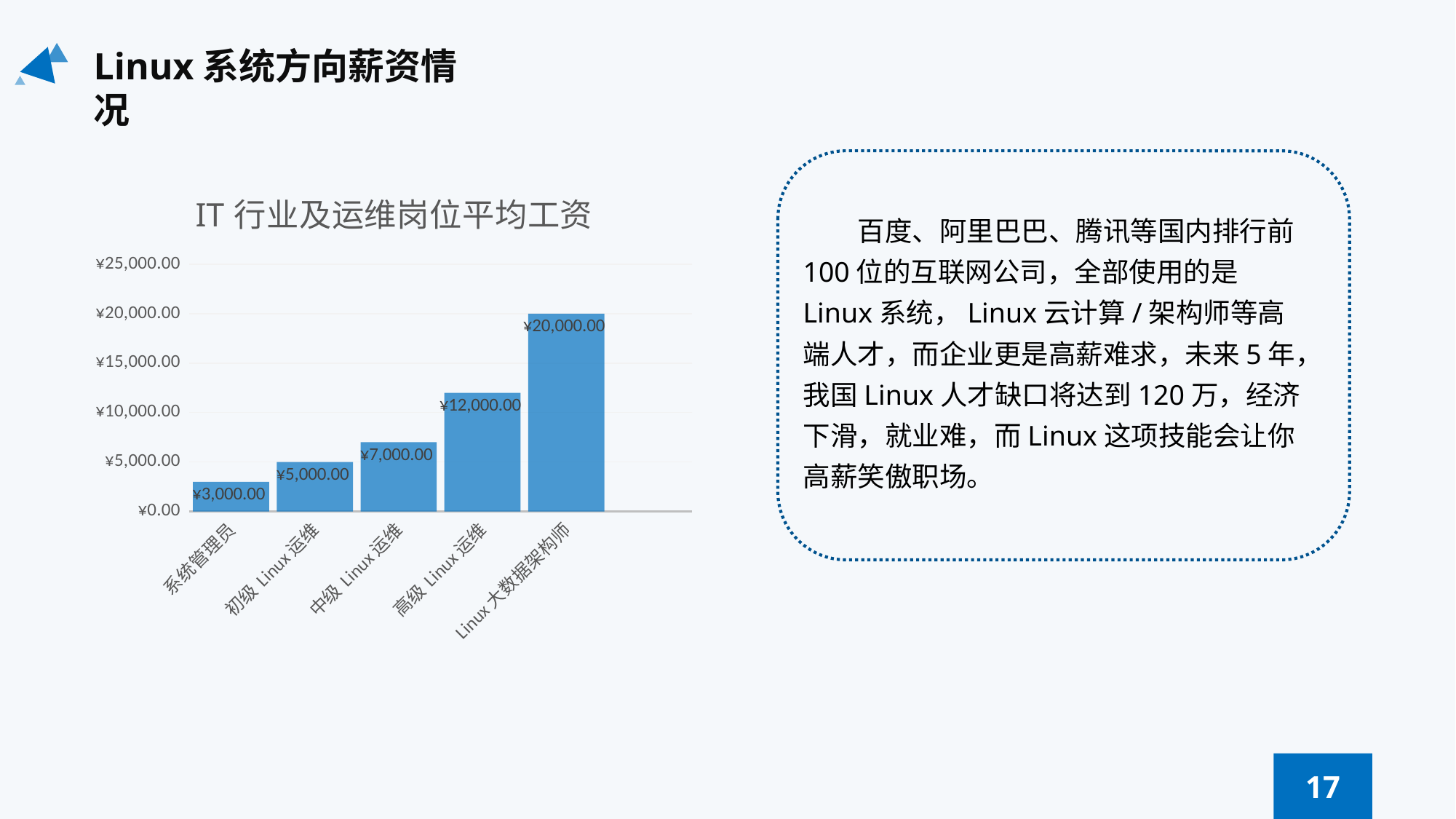
What is the average salary shown for 中级 Linux 运维? ¥7,000.00 What is the average salary shown for 系统管理员? ¥3,000.00 What is the title of the chart? IT 行业及运维岗位平均工资 What is the difference between the average salary of 初级 Linux 运维 and 系统管理员? ¥2,000.00 How many positions are shown in the chart? 5 Is the value for 高级 Linux 运维 greater or less than ¥10,000.00? greater Which has a higher average salary, 中级 Linux 运维 or 初级 Linux 运维? 中级 Linux 运维 What is the difference between the average salary of Linux 大数据架构师 and 高级 Linux 运维? ¥8,000.00 What is the average salary shown for 高级 Linux 运维? ¥12,000.00 Which position has the lowest average salary in the chart? 系统管理员 Which position has the highest average salary in the chart? Linux 大数据架构师 What type of chart is shown on the slide? bar chart